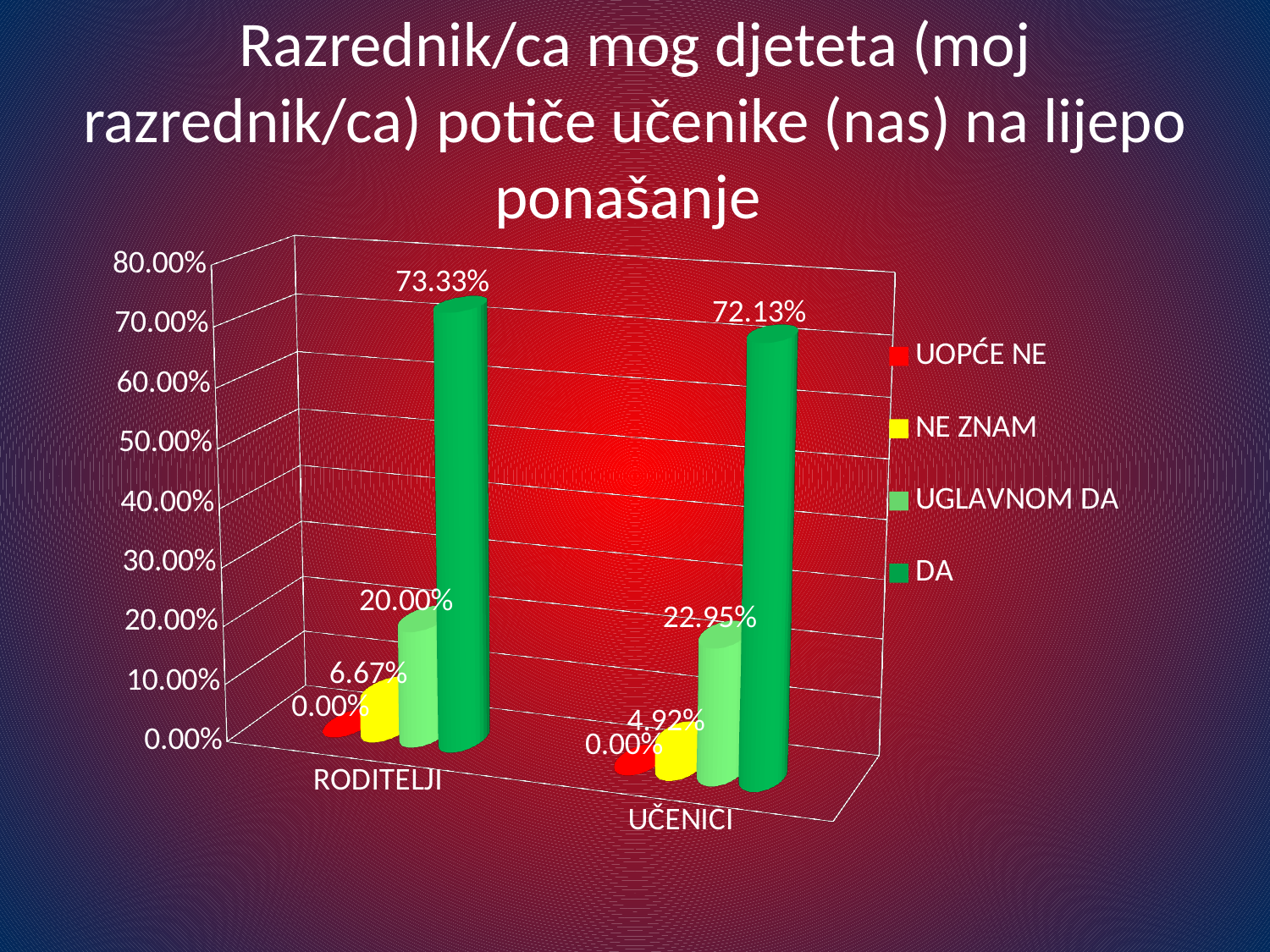
What is the value for UGLAVNOM DA in the UČENICI category? 22.95% Which series has the lowest value in the UČENICI category? UOPĆE NE What is the difference between the UGLAVNOM DA values for UČENICI and RODITELJI? 2.95% What is the value for DA in the UČENICI category? 72.13% What is the value for DA in the RODITELJI category? 73.33% Which is larger: the NE ZNAM value for RODITELJI or for UČENICI? RODITELJI How many series does the legend list? 4 How many categories are shown on the x axis? 2 What is the value for UOPĆE NE in the UČENICI category? 0.00% Which series has the highest value in the RODITELJI category? DA What is the value for NE ZNAM in the RODITELJI category? 6.67% What kind of chart is shown on the slide? Bar chart